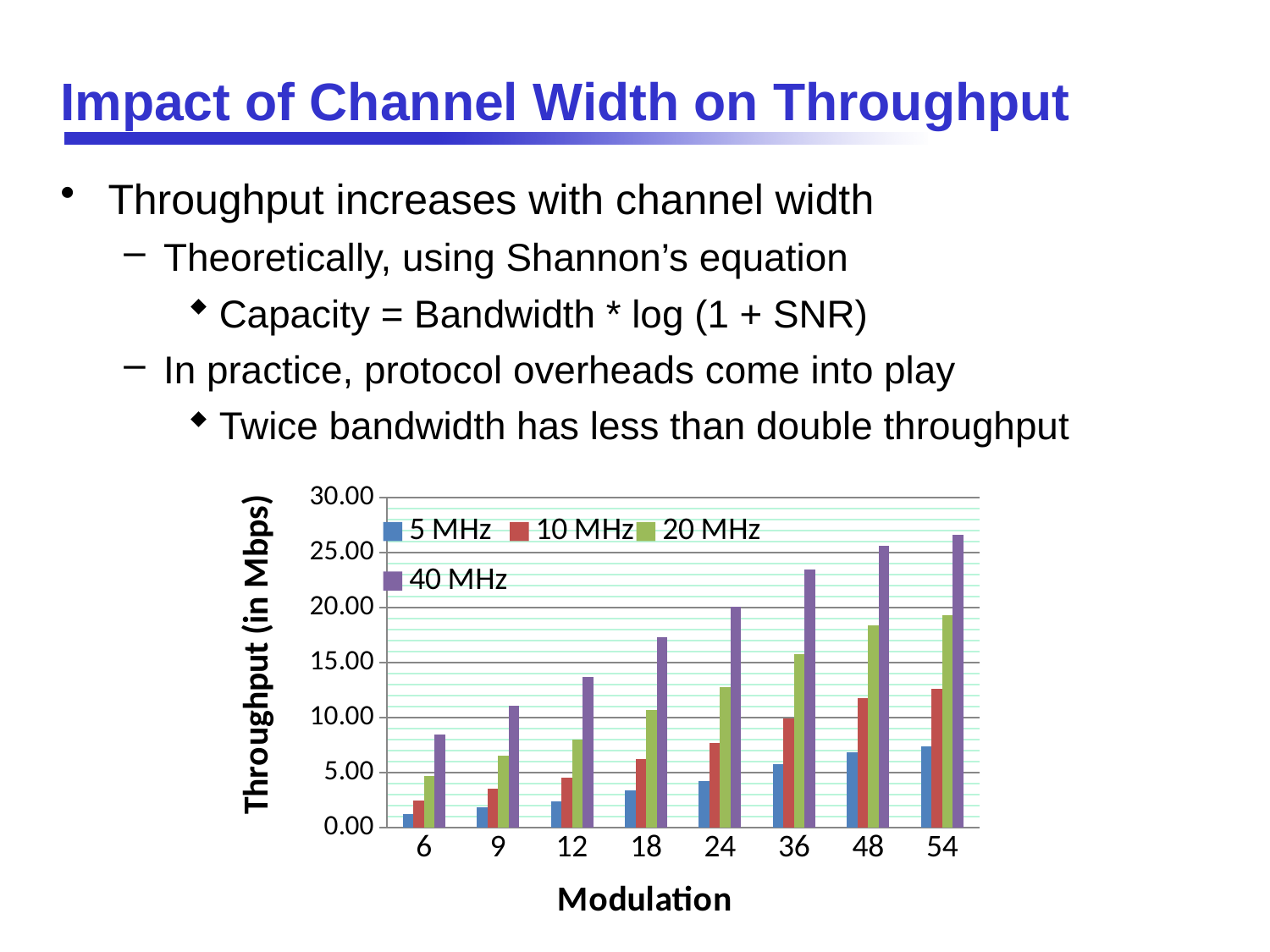
How many modulation categories are shown on the x axis? 8 Is the 40 MHz throughput at modulation 54 greater or less than 25.00? greater Is the 40 MHz throughput at modulation 6 greater or less than 10.00? less Does the 40 MHz throughput rise or fall as modulation increases from 6 to 54? rise Which channel width has the lowest throughput at modulation 6? 5 MHz What kind of chart is shown on the slide? bar chart How many series does the legend list? 4 Is the 20 MHz throughput at modulation 36 greater or less than 15.00? greater Which channel width has the highest throughput at modulation 54? 40 MHz Which is larger at modulation 24: the 20 MHz throughput or the 10 MHz throughput? 20 MHz What is the label of the y axis? Throughput (in Mbps)